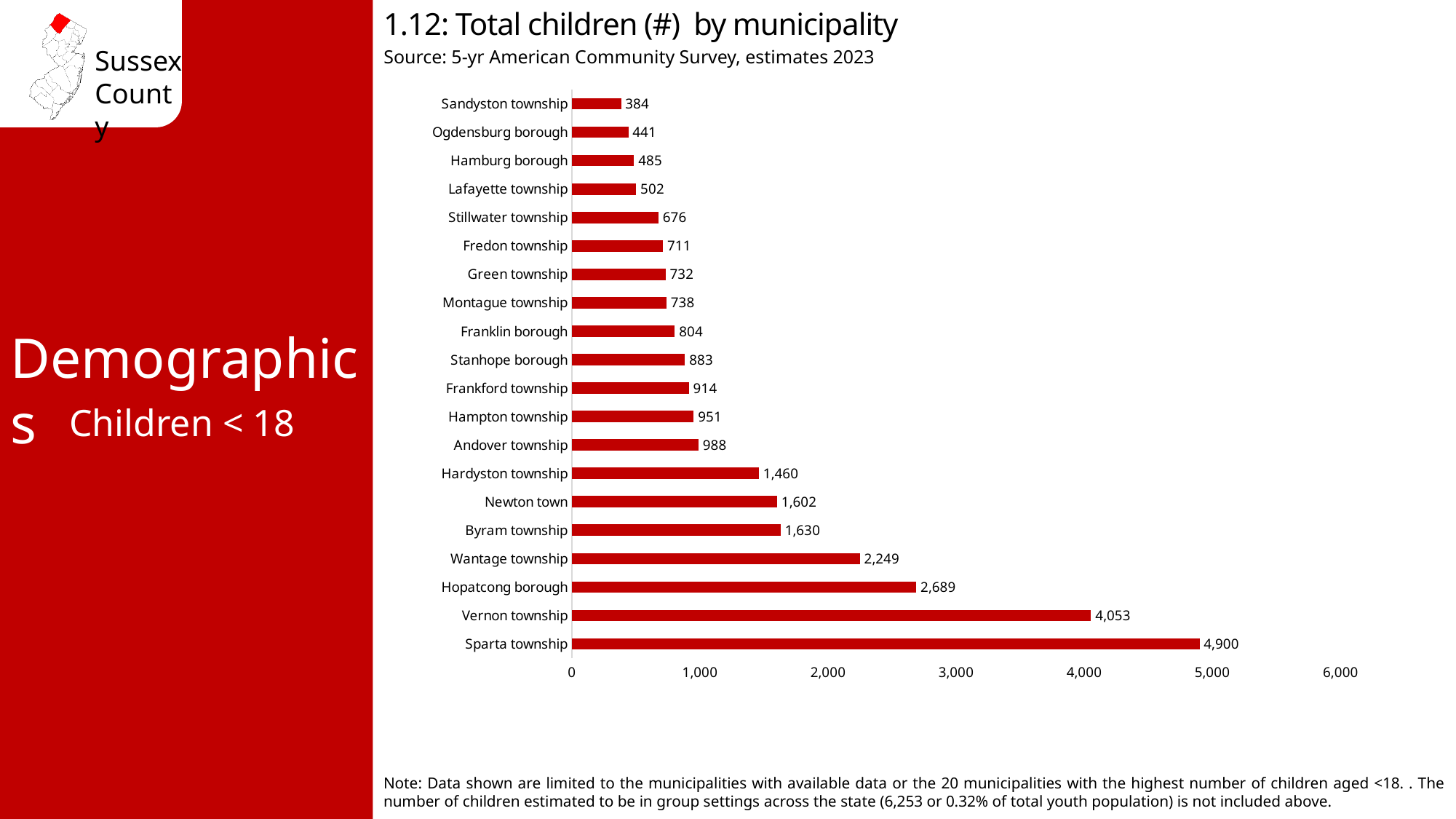
What kind of chart is used to show total children by municipality? bar chart What is the difference in the number of children between Hardyston township and Andover township? 472 What is the difference in the number of children between Sparta township and Vernon township? 847 Which has more children, Newton town or Byram township? Byram township What is the total number of children for Sparta township? 4,900 Is the value for Wantage township greater or less than 2,000? greater Which municipality has the lowest number of children? Sandyston township What is the total number of children for Hopatcong borough? 2,689 How many municipalities are shown in the chart? 20 What is the total number of children for Fredon township? 711 Which municipality has the highest number of children? Sparta township What is the data source cited for the chart? 5-yr American Community Survey, estimates 2023